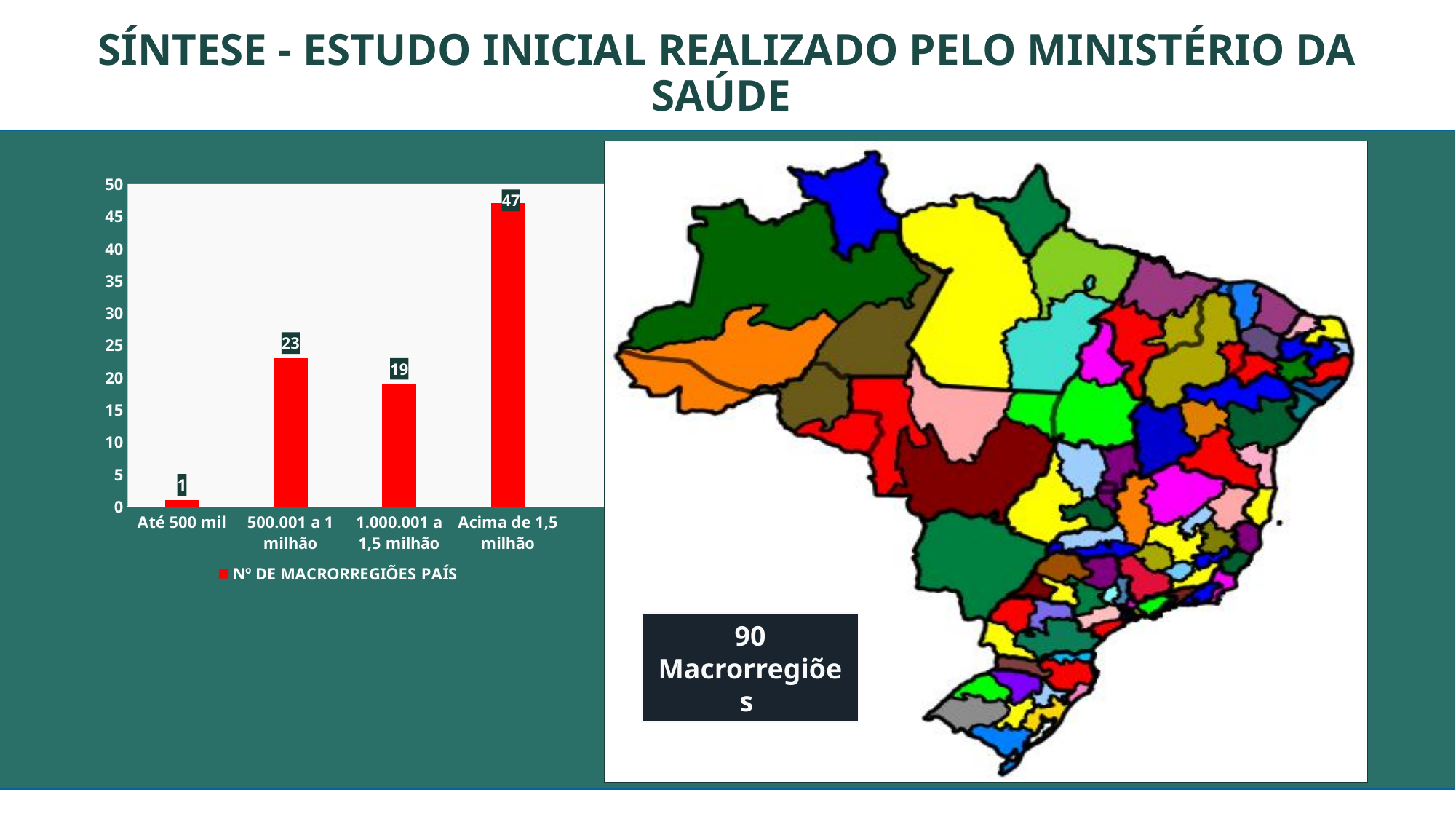
What is the value for "Acima de 1,5 milhão"? 47 What is the value for "Até 500 mil"? 1 What is the value for "500.001 a 1 milhão"? 23 Which category has the lowest value? Até 500 mil How many categories are shown on the x axis of the bar chart? 4 What kind of chart is shown on the slide? bar chart Which is larger, the value for "500.001 a 1 milhão" or the value for "1.000.001 a 1,5 milhão"? 500.001 a 1 milhão What series name does the chart legend show? Nº DE MACRORREGIÕES PAÍS Is the value for "Acima de 1,5 milhão" greater or less than 40? greater What is the value for "1.000.001 a 1,5 milhão"? 19 What is the difference between the values for "Acima de 1,5 milhão" and "500.001 a 1 milhão"? 24 Which category has the highest value? Acima de 1,5 milhão